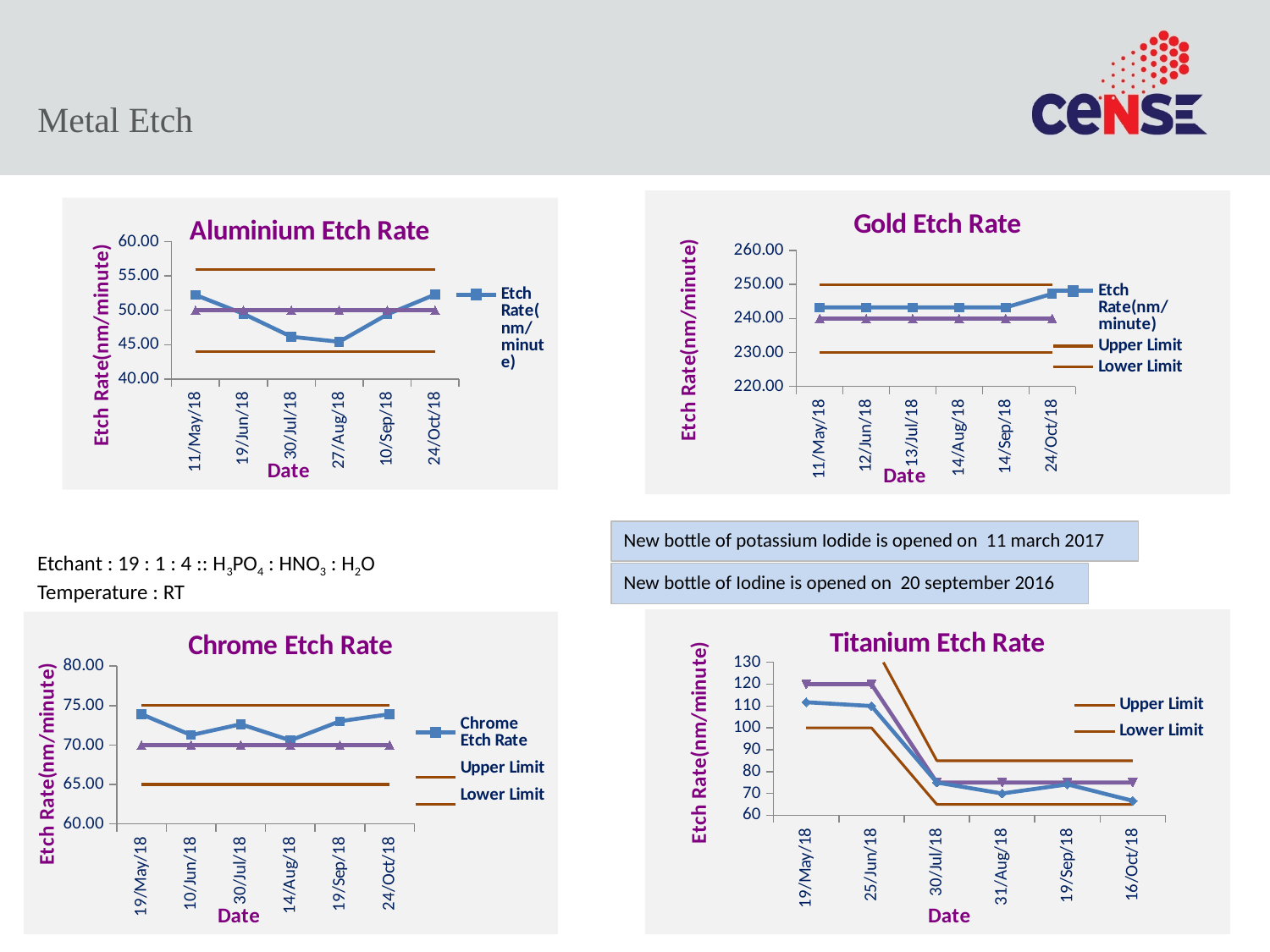
In the Titanium Etch Rate chart, is the etch rate for 31/Aug/18 greater or less than 80? less In the Aluminium Etch Rate chart, is the etch rate for 11/May/18 greater or less than 50.00? greater In the Aluminium Etch Rate chart, is the etch rate for 30/Jul/18 greater or less than 50.00? less What is the title of the chart in the bottom-right of the slide? Titanium Etch Rate What kind of chart is the Aluminium Etch Rate chart? line chart In the Gold Etch Rate chart, on which date is the etch rate highest? 24/Oct/18 In the Titanium Etch Rate chart, do the etch rate values generally rise or fall from 19/May/18 to 16/Oct/18? fall In the Gold Etch Rate chart, how many series does the legend list? 3 In the Aluminium Etch Rate chart, how many dates are plotted on the x axis? 6